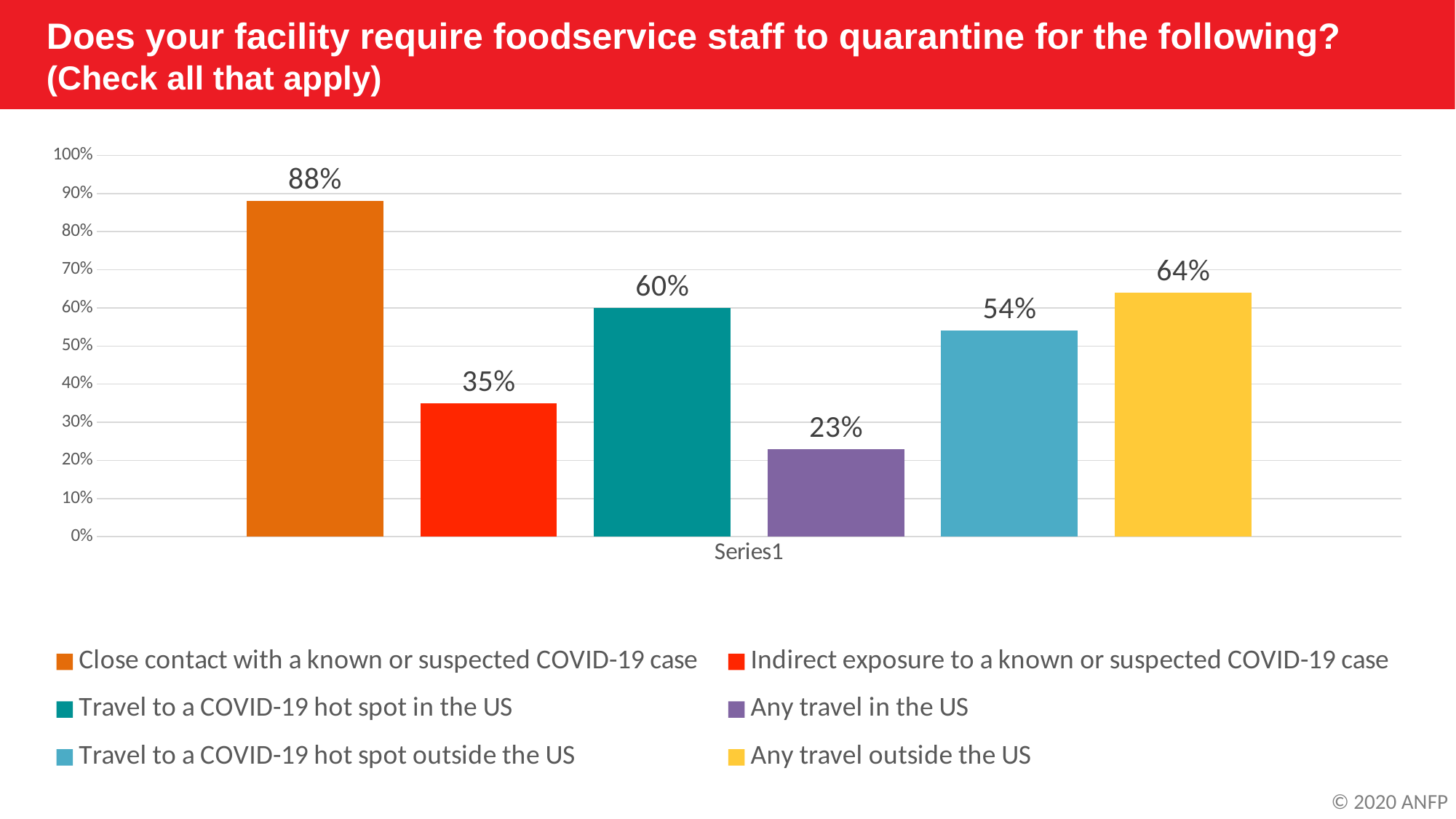
Is the value for indirect exposure to a known or suspected COVID-19 case greater or less than 40%? less What percentage of facilities require quarantine for close contact with a known or suspected COVID-19 case? 88% What colour is the bar for any travel outside the US? Yellow How many entries does the legend list? 6 Which is larger: the percentage for travel to a COVID-19 hot spot in the US or the percentage for indirect exposure to a known or suspected COVID-19 case? Travel to a COVID-19 hot spot in the US Which category has the lowest percentage? Any travel in the US What percentage of facilities require quarantine for travel to a COVID-19 hot spot outside the US? 54% What is the difference between the percentage for any travel outside the US and the percentage for any travel in the US? 41% What type of chart is shown on the slide? Bar chart What percentage of facilities require quarantine for any travel in the US? 23% Which category has the highest percentage? Close contact with a known or suspected COVID-19 case How many bars are shown in the chart? 6